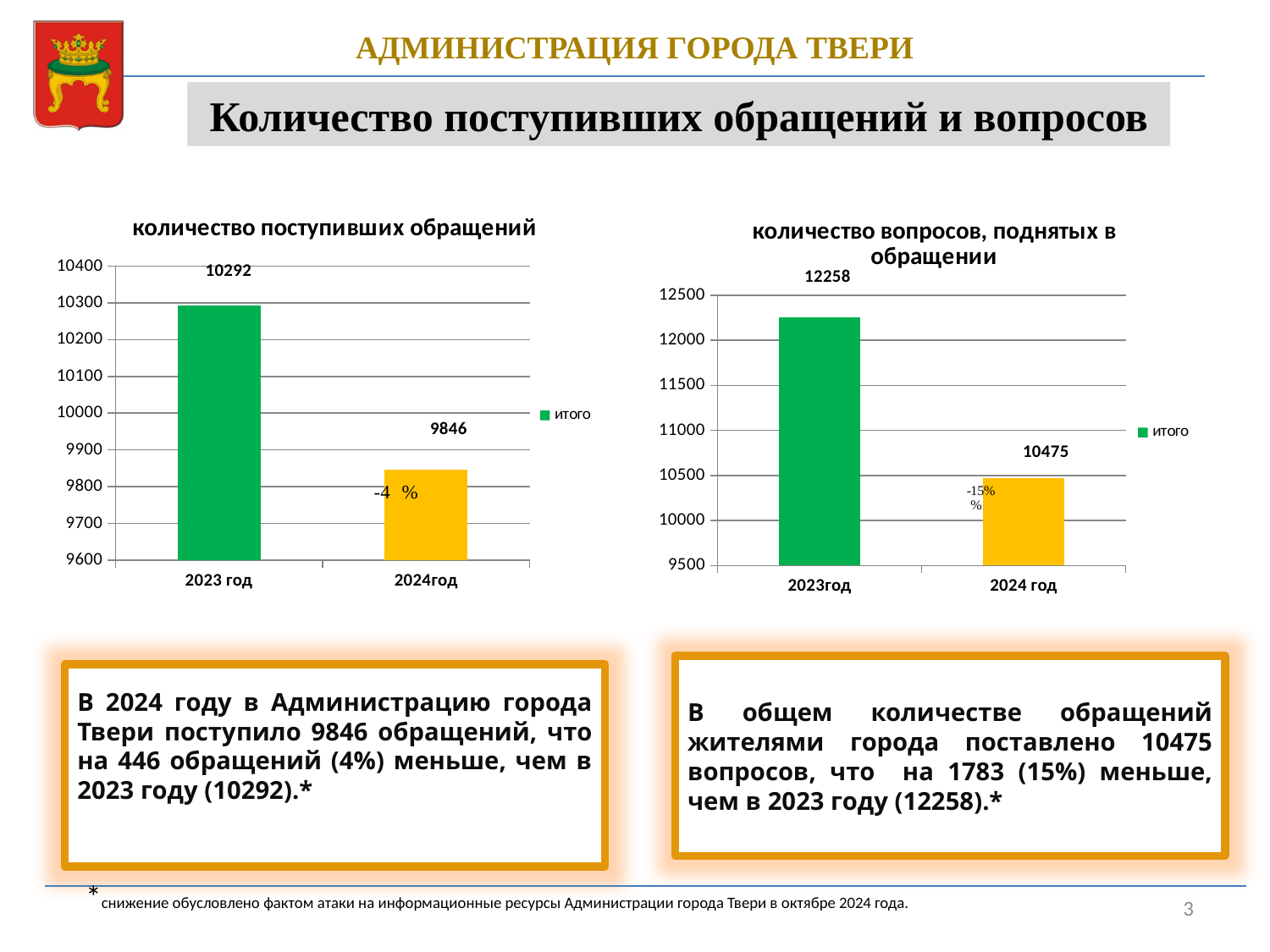
In the right chart (количество вопросов, поднятых в обращении), what is the difference between the 2023 and 2024 values? 1783 In the right chart (количество вопросов, поднятых в обращении), is the value for 2024 год greater or less than 11000? less In the chart titled "количество поступивших обращений", what is the value for 2024год? 9846 In the chart titled "количество поступивших обращений", what is the value for 2023 год? 10292 What type of chart is the right chart (количество вопросов, поднятых в обращении)? bar chart How many categories are shown on the x axis of the left chart (количество поступивших обращений)? 2 In the left chart (количество поступивших обращений), which year has the higher value? 2023 год In the left chart (количество поступивших обращений), what is the difference between the 2023 and 2024 values? 446 In the chart titled "количество вопросов, поднятых в обращении", what is the value for 2024 год? 10475 What is the legend entry shown in the left chart (количество поступивших обращений)? итого In the right chart (количество вопросов, поднятых в обращении), which year has the lower value? 2024 год In the chart titled "количество вопросов, поднятых в обращении", what is the value for 2023год? 12258